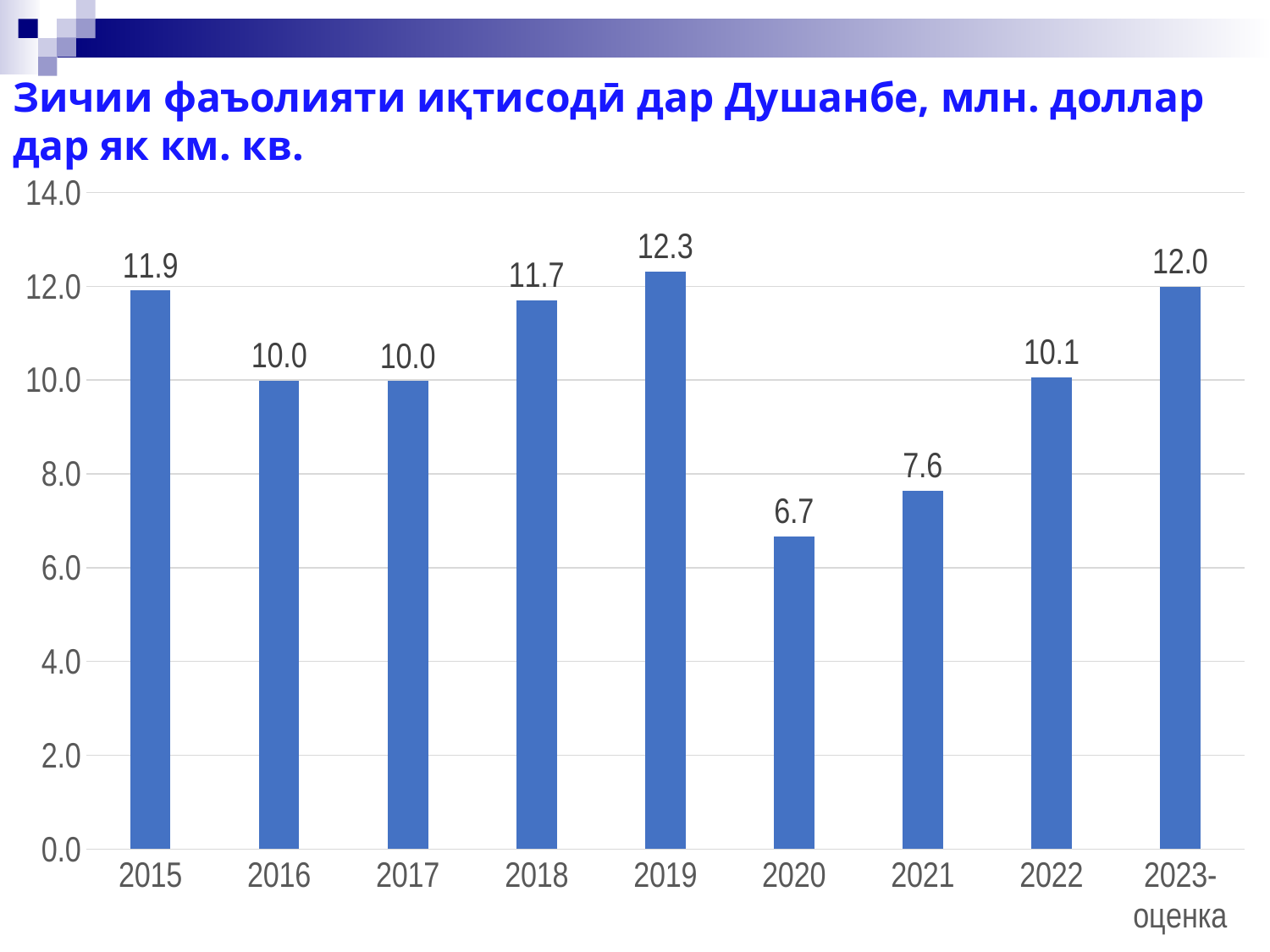
What is the value for 2020? 6.7 What kind of chart is this? bar chart How many years are shown on the x axis? 9 What is the difference between the values for 2019 and 2020? 5.6 Is the value for 2021 greater or less than 8.0? less Which is larger, the value for 2015 or the value for 2018? 2015 Which year has the highest value? 2019 What is the value for 2023-оценка? 12.0 Which year has the lowest value? 2020 Do the values rise or fall from 2019 to 2020? fall What is the difference between the values for 2022 and 2021? 2.5 What is the value for 2019? 12.3